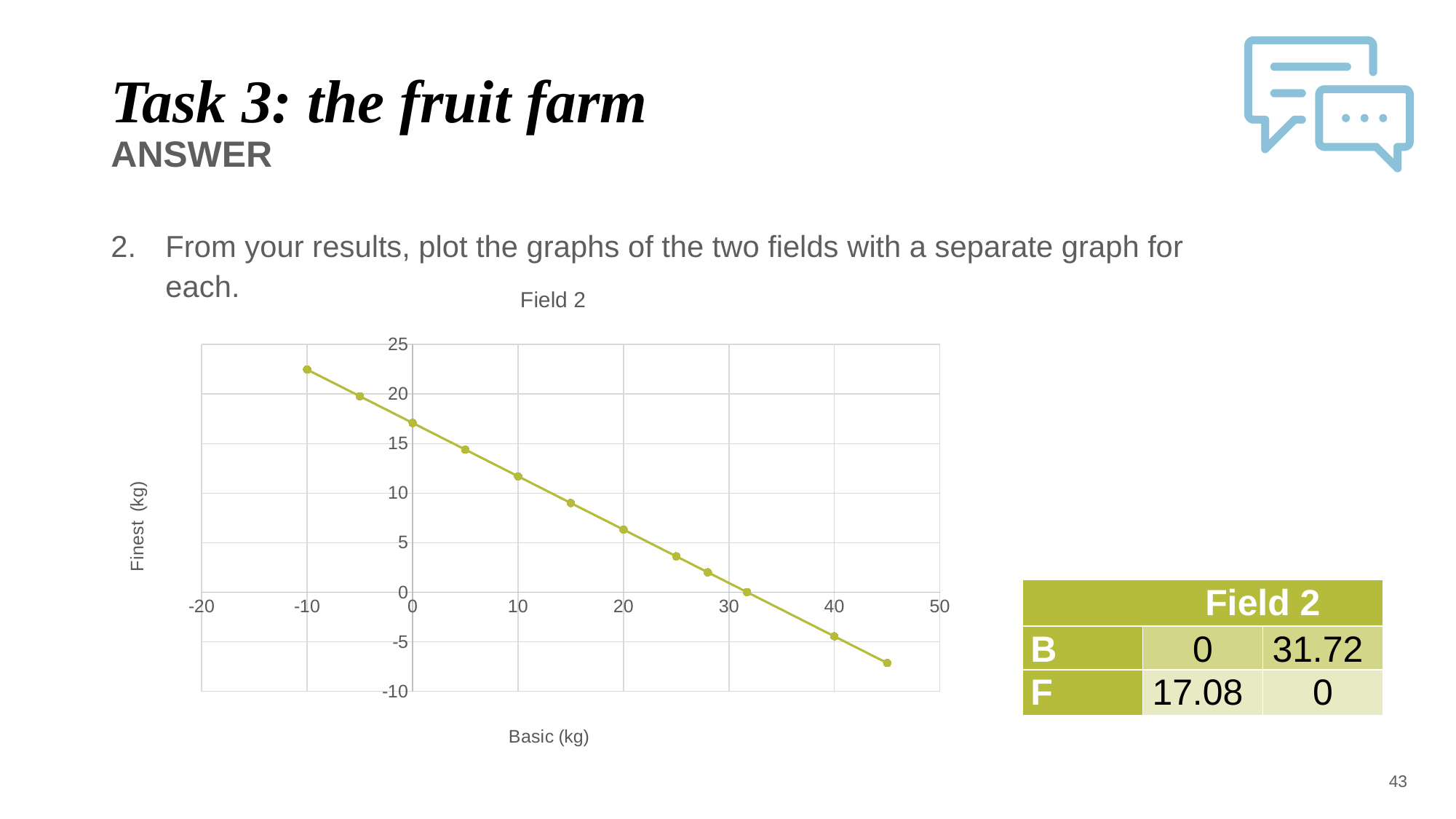
Is the Finest (kg) value at Basic = -10 greater or less than 20? greater What kind of chart is shown on the slide? line chart What is the label of the x axis of the chart? Basic (kg) Is the Finest (kg) value at Basic = 40 greater or less than 0? less Is the Finest (kg) value at Basic = 20 greater or less than 5? greater Which plotted point has the highest Finest (kg) value, the one at Basic = -10 or the one at Basic = 45? Basic = -10 According to the Field 2 table, what is the value of F when B is 0? 17.08 How many data points are plotted on the chart? 12 Do the plotted values rise or fall as Basic (kg) increases? fall What is the title of the chart? Field 2